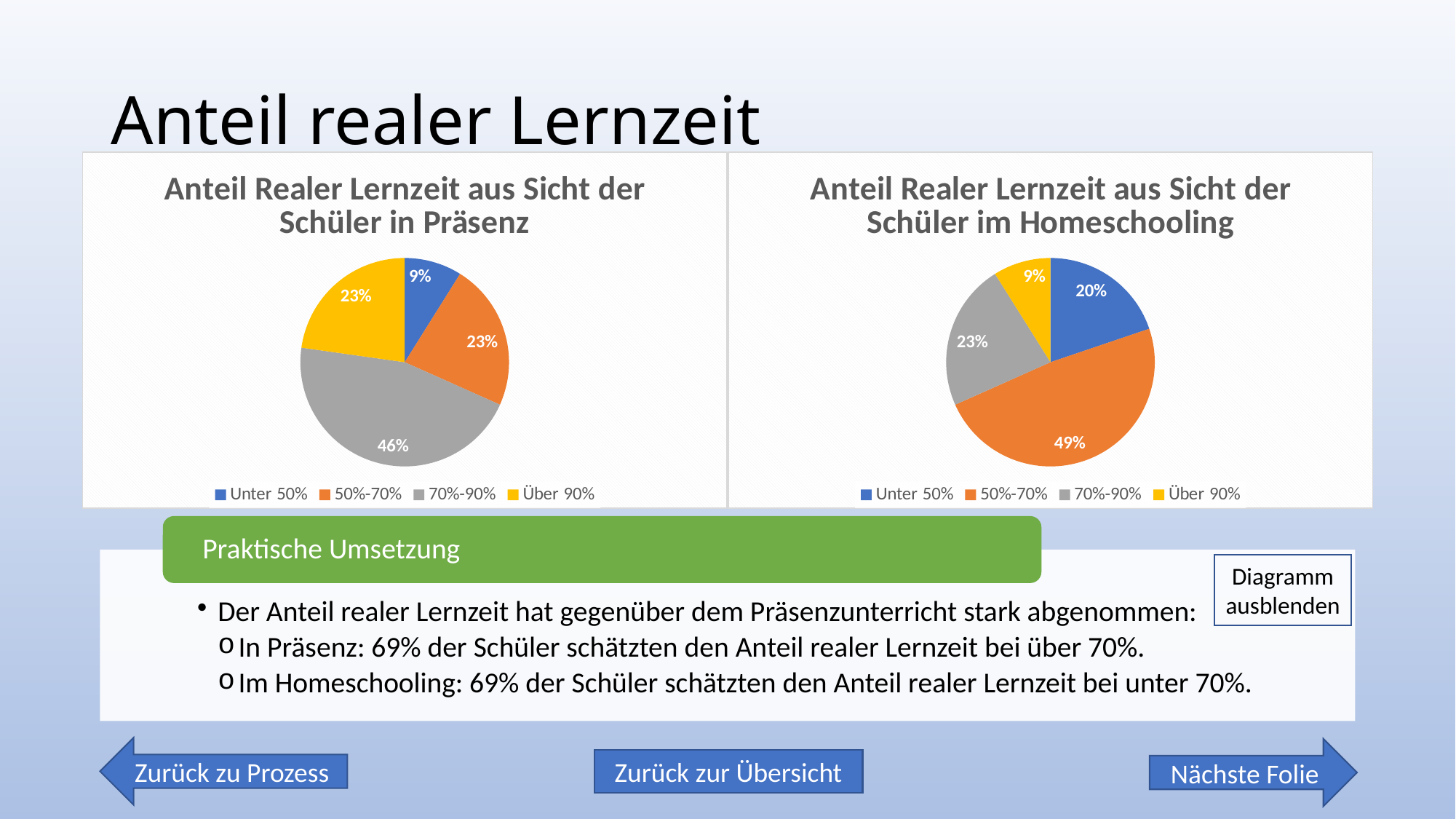
In the chart 'Anteil Realer Lernzeit aus Sicht der Schüler in Präsenz', what share is labelled for the 'Unter 50%' slice? 9% In the chart 'Anteil Realer Lernzeit aus Sicht der Schüler im Homeschooling', which category has the largest slice? 50%-70% In the chart 'Anteil Realer Lernzeit aus Sicht der Schüler in Präsenz', what share is labelled for the '70%-90%' slice? 46% In the chart 'Anteil Realer Lernzeit aus Sicht der Schüler im Homeschooling', what share is labelled for the 'Unter 50%' slice? 20% In the chart 'Anteil Realer Lernzeit aus Sicht der Schüler in Präsenz', which category has the largest slice? 70%-90% In the chart 'Anteil Realer Lernzeit aus Sicht der Schüler im Homeschooling', which is larger: the 'Unter 50%' slice or the '70%-90%' slice? 70%-90% How many categories does the legend of the chart 'Anteil Realer Lernzeit aus Sicht der Schüler in Präsenz' list? 4 In the chart 'Anteil Realer Lernzeit aus Sicht der Schüler in Präsenz', what is the difference between the '70%-90%' slice and the 'Über 90%' slice? 23% What type of chart is 'Anteil Realer Lernzeit aus Sicht der Schüler im Homeschooling'? Pie chart In the chart 'Anteil Realer Lernzeit aus Sicht der Schüler in Präsenz', what colour is the 'Über 90%' slice? Yellow In the chart 'Anteil Realer Lernzeit aus Sicht der Schüler im Homeschooling', which category has the smallest slice? Über 90% In the chart 'Anteil Realer Lernzeit aus Sicht der Schüler im Homeschooling', what share is labelled for the '50%-70%' slice? 49%